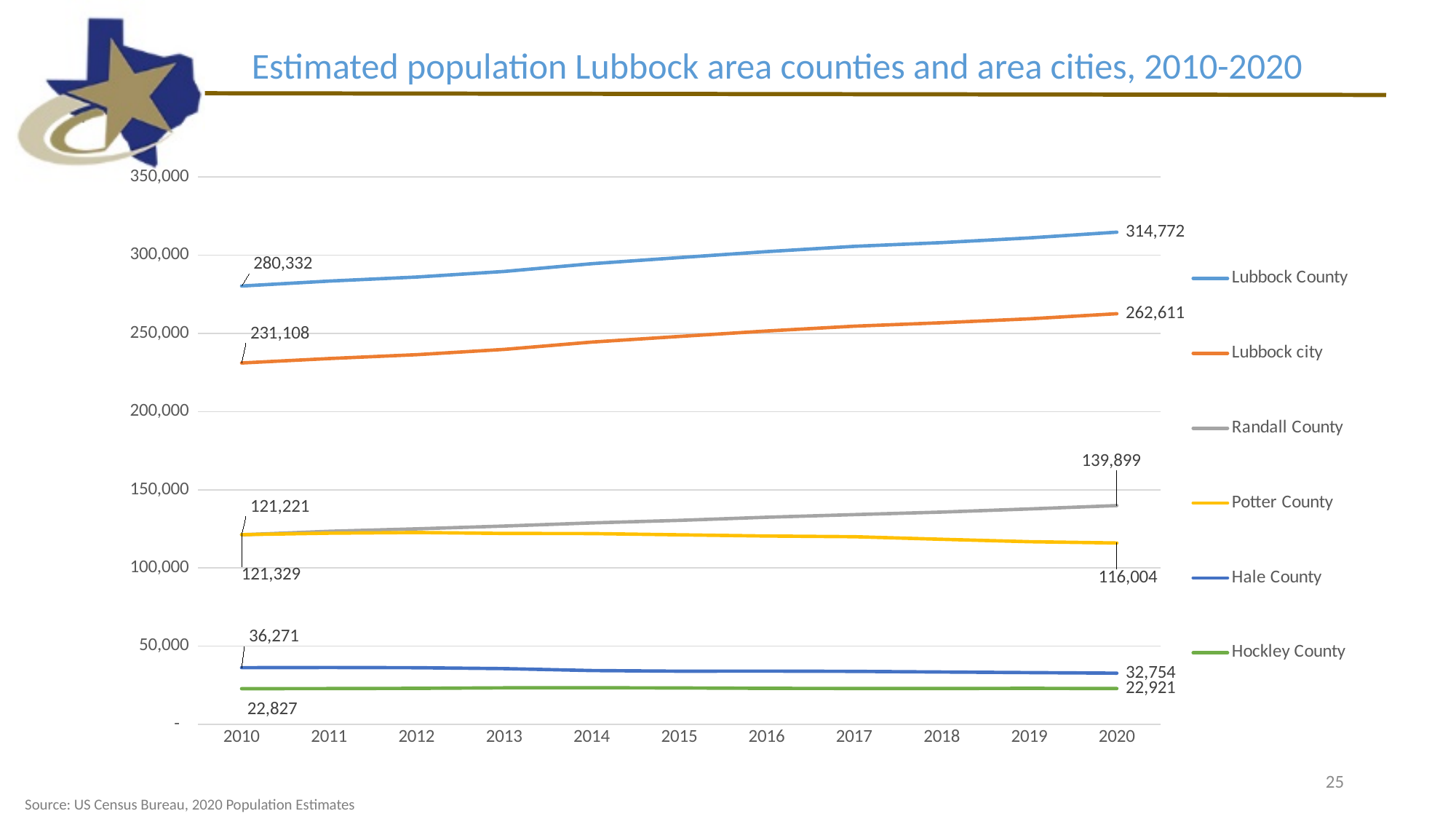
In 2020, which has the larger population, Randall County or Potter County? Randall County By how much did the Lubbock city population increase from 2010 to 2020? 31,503 What is the estimated population of Hale County in 2010? 36,271 What is the estimated population of Lubbock County in 2020? 314,772 What kind of chart is shown on the slide? line chart How many series does the legend list? 6 What is the estimated population of Potter County in 2020? 116,004 Does the Hale County population rise or fall from 2010 to 2020? fall What is the estimated population of Lubbock city in 2010? 231,108 By how much did the Lubbock County population increase from 2010 to 2020? 34,440 What is the estimated population of Randall County in 2020? 139,899 What is the estimated population of Hockley County in 2020? 22,921